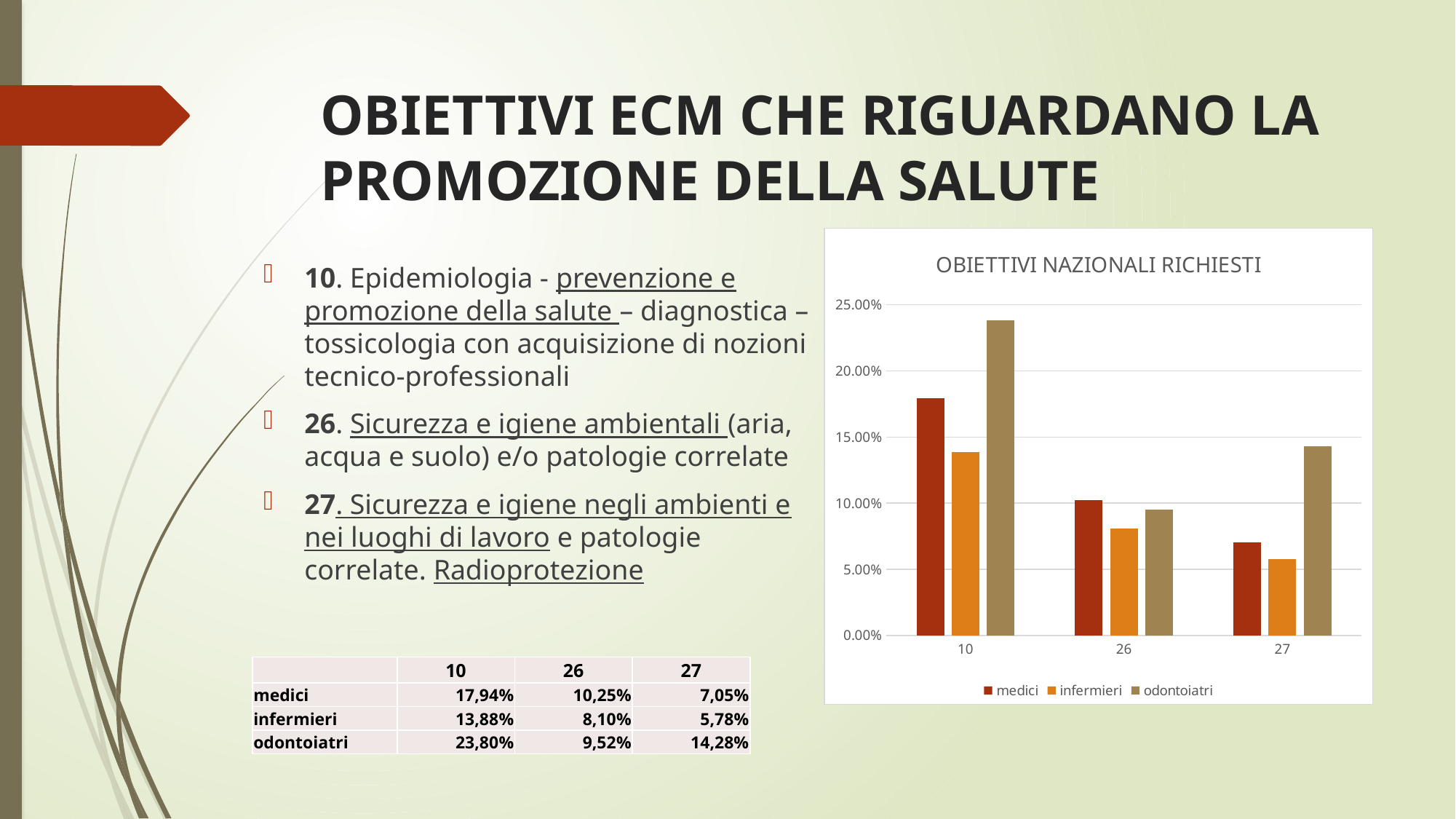
How many series does the chart legend list? 3 What type of chart is shown on the slide? bar chart According to the table on the slide, what is the value for infermieri in category 27? 5,78% Is the value for infermieri in category 26 greater or less than 10.00%? less Is the value for medici in category 10 greater or less than 15.00%? greater Using the table values, what is the difference between odontoiatri and medici in category 27? 7,23% How many categories are shown on the x axis of the chart? 3 Which series has the lowest value in category 27? infermieri Which series has the highest value in category 10? odontoiatri Which is larger: the value for medici in category 26 or the value for odontoiatri in category 26? medici What is the title of the chart? OBIETTIVI NAZIONALI RICHIESTI According to the table on the slide, what is the value for odontoiatri in category 10? 23,80%